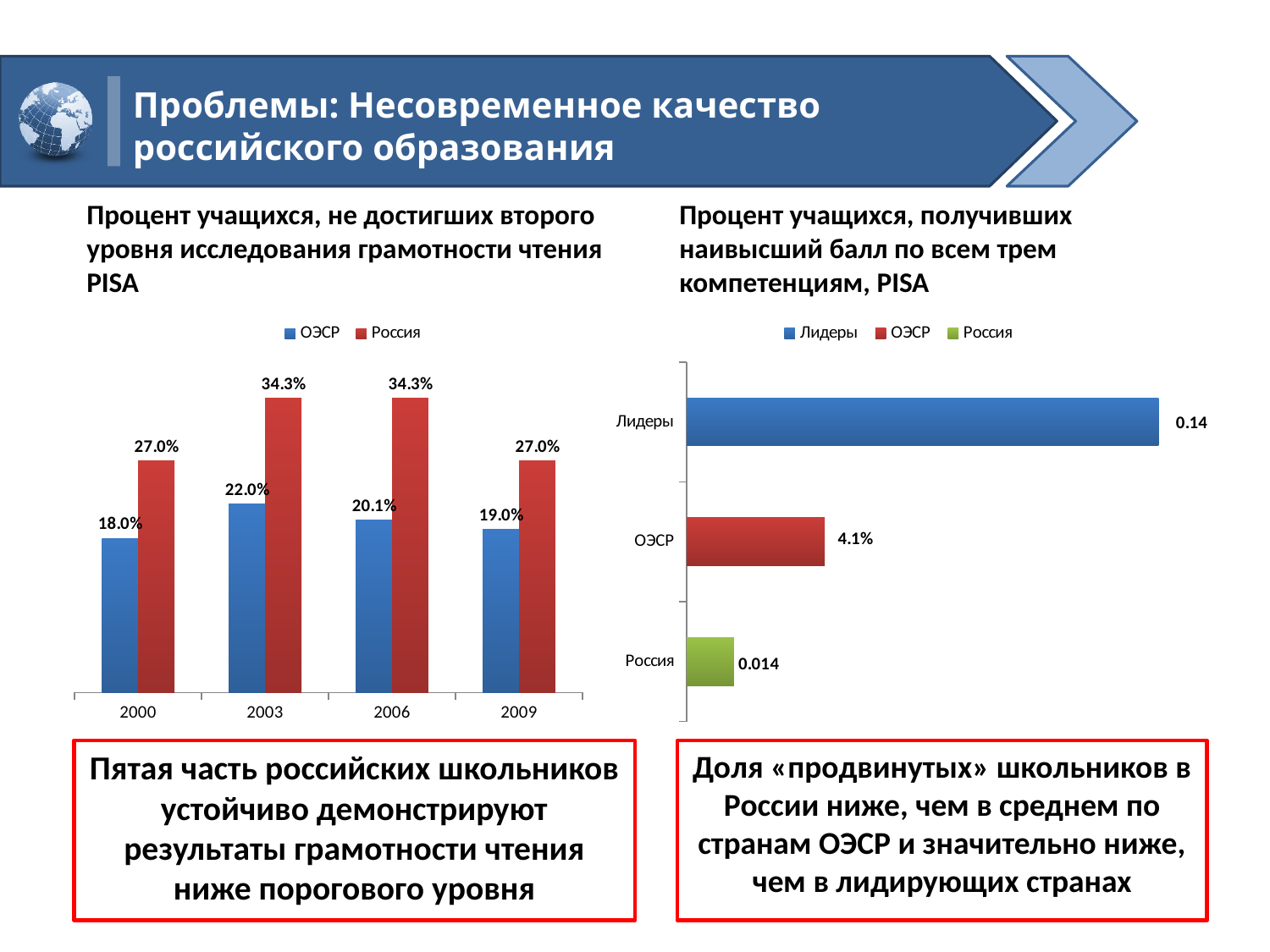
In the right chart, what is the value for Россия? 0.014 In the right chart, which category has the longest bar? Лидеры In the left chart, what is the value for Россия in 2003? 34.3% In the right chart, what is the value for ОЭСР? 4.1% In the left chart, which is larger in 2000: ОЭСР or Россия? Россия In the left chart, what is the value for ОЭСР in 2006? 20.1% What kind of chart is the right chart? Bar chart How many years are shown on the x axis of the left chart? 4 In the left chart, what is the value for ОЭСР in 2000? 18.0% In the left chart, what is the difference between Россия and ОЭСР in 2009? 8.0% In the left chart, which year has the highest value for ОЭСР? 2003 How many series does the legend of the left chart list? 2